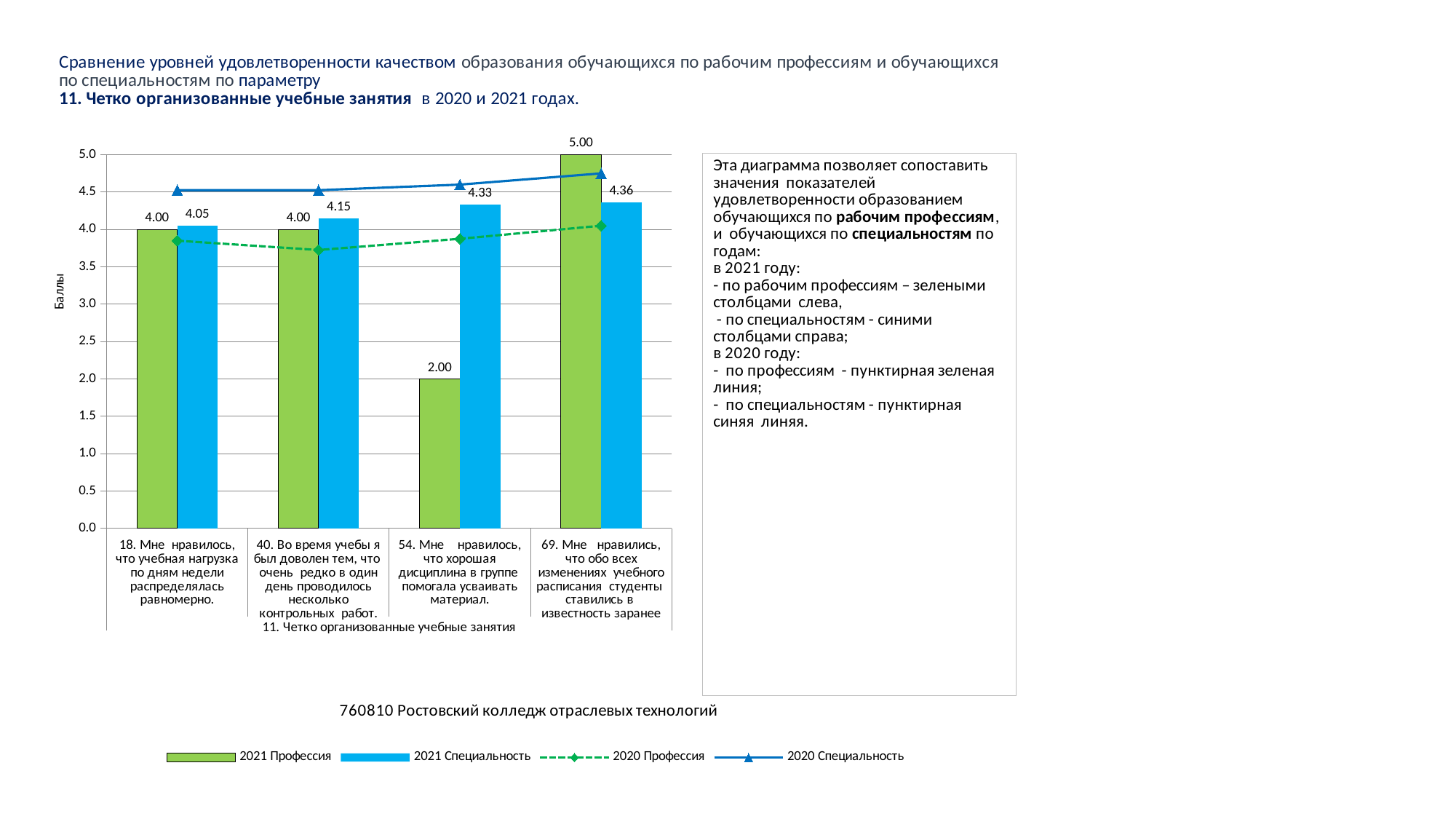
What is the value of the 2021 Профессия bar for category 54 (Мне нравилось, что хорошая дисциплина в группе помогала усваивать материал)? 2.00 Which category has the highest 2021 Профессия bar? 69. Мне нравились, что обо всех изменениях учебного расписания студенты ставились в известность заранее How many series does the legend list? 4 Is the 2020 Специальность line value for category 18 greater or less than 4.0? greater For category 69, which is larger: the 2021 Профессия bar or the 2021 Специальность bar? 2021 Профессия What is the value of the 2021 Специальность bar for category 40 (Во время учебы я был доволен тем, что очень редко в один день проводилось несколько контрольных работ)? 4.15 What is the label of the vertical axis? Баллы Which category has the lowest 2021 Профессия bar? 54. Мне нравилось, что хорошая дисциплина в группе помогала усваивать материал. What is the difference between the 2021 Специальность and 2021 Профессия values for category 54? 2.33 How many categories are shown on the x axis? 4 What is the value of the 2021 Специальность bar for category 69 (Мне нравились, что обо всех изменениях учебного расписания студенты ставились в известность заранее)? 4.36 Is the 2020 Профессия line value for category 40 greater or less than 4.0? less